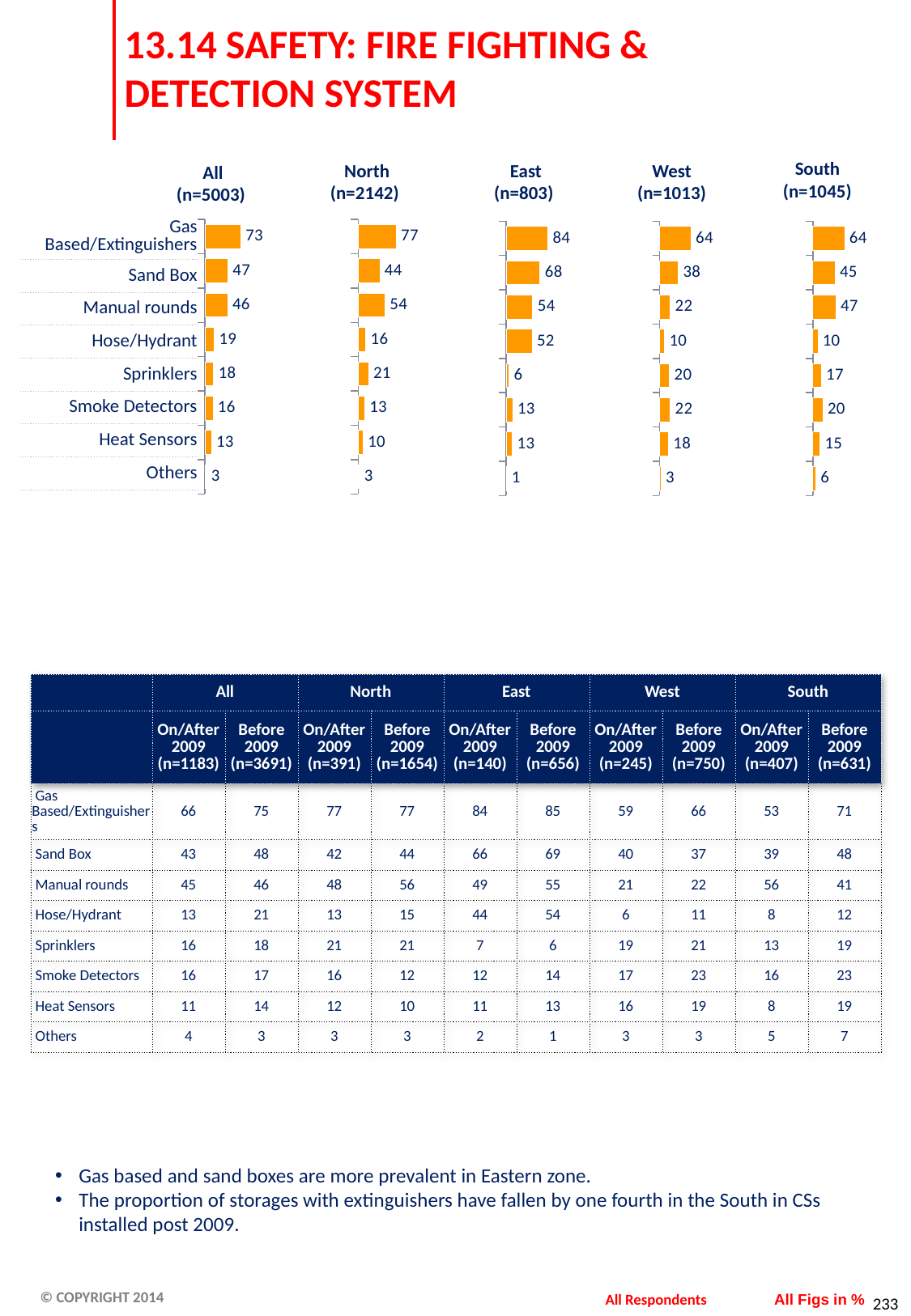
In the East (n=803) chart, what is the value for Hose/Hydrant? 52 In the North (n=2142) chart, which is larger: Manual rounds or Sand Box? Manual rounds What type of chart is used for the North (n=2142) data? Bar chart In the South (n=1045) chart, which category has the highest value? Gas Based/Extinguishers In the West (n=1013) chart, what is the value for Sand Box? 38 In the West (n=1013) chart, which is larger: Sprinklers or Hose/Hydrant? Sprinklers How many bar charts are shown on the slide? 5 In the South (n=1045) chart, what is the value for Others? 6 In the North (n=2142) chart, which category has the lowest value? Others How many categories are shown in the All (n=5003) chart? 8 In the All (n=5003) chart, what is the value for Gas Based/Extinguishers? 73 In the East (n=803) chart, what is the difference between Gas Based/Extinguishers and Sand Box? 16